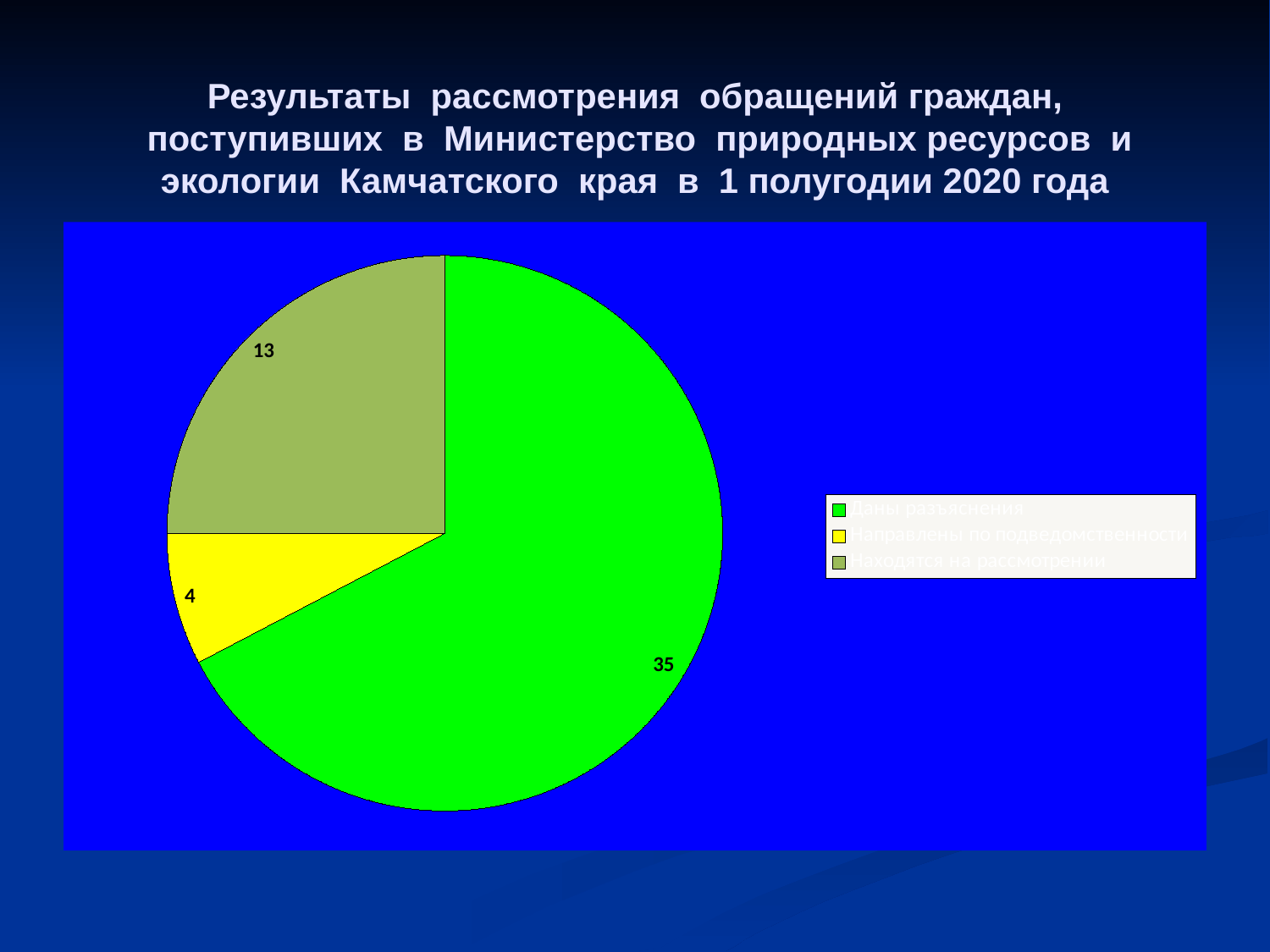
What is the value of the slice labelled "Направлены по подведомственности"? 4 What is the value of the slice labelled "Даны разъяснения"? 35 What share of the pie does the "Находятся на рассмотрении" slice represent? 25% What is the difference between the values for "Даны разъяснения" and "Находятся на рассмотрении"? 22 What is the value of the slice labelled "Находятся на рассмотрении"? 13 Which category has the largest slice of the pie? Даны разъяснения How many slices does the pie chart have? 3 What type of chart is shown on the slide? pie chart Which category has the smallest slice of the pie? Направлены по подведомственности Which is larger: the value for "Находятся на рассмотрении" or the value for "Направлены по подведомственности"? Находятся на рассмотрении What colour is the slice for "Даны разъяснения"? green What is the total of all the values shown in the pie chart? 52